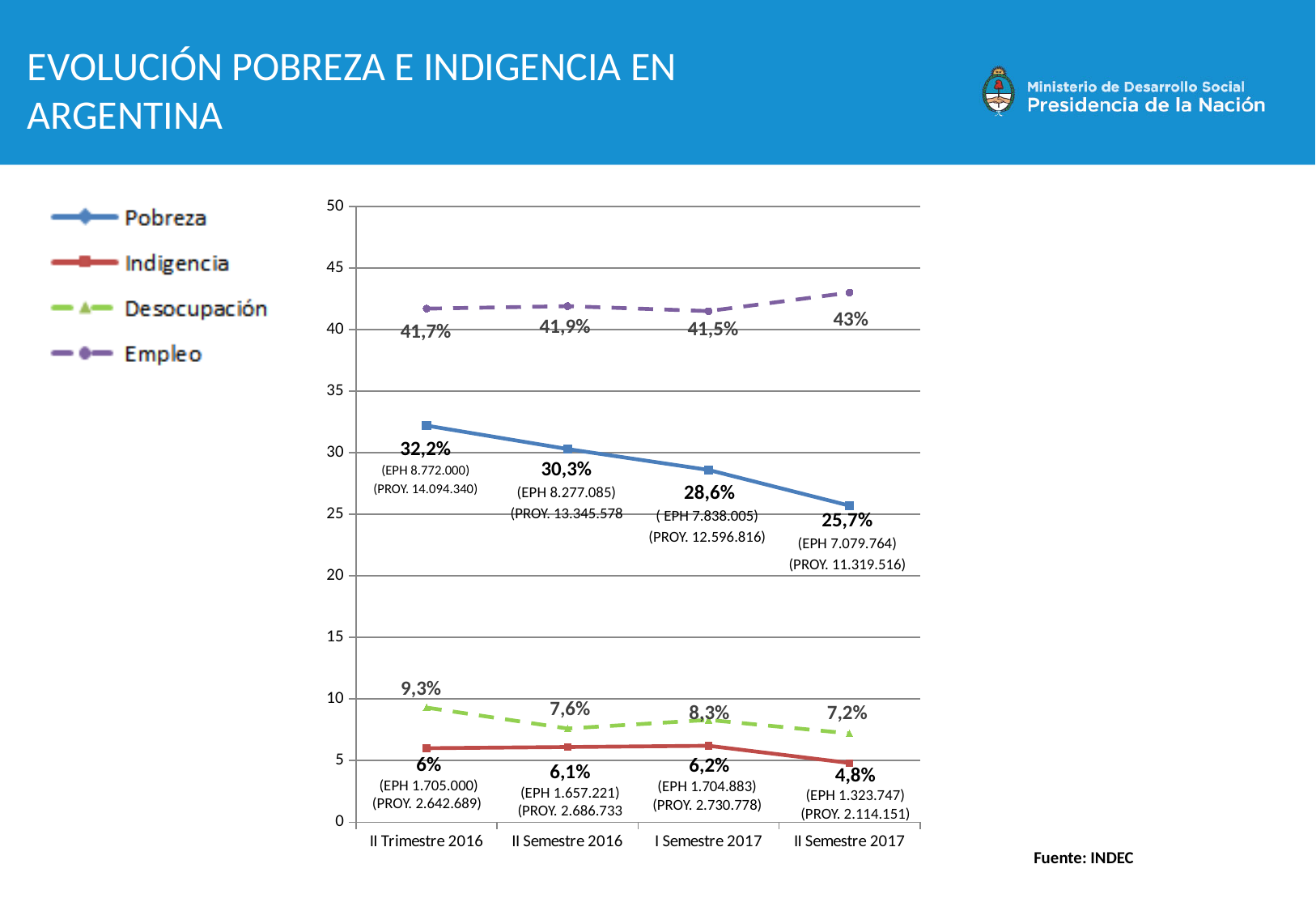
What is the Desocupación value for II Trimestre 2016? 9,3% Does the Pobreza series rise or fall from II Trimestre 2016 to II Semestre 2017? Fall What is the difference between the Pobreza values for II Trimestre 2016 and II Semestre 2017? 6,5% What kind of chart is shown on the slide? Line chart In which period is Pobreza highest? II Trimestre 2016 How many series does the legend list? 4 In which period is Indigencia lowest? II Semestre 2017 What is the Indigencia value for II Semestre 2016? 6,1% How many periods are shown on the x axis? 4 What is the Empleo value for I Semestre 2017? 41,5% Which is larger, Desocupación in II Semestre 2016 or in I Semestre 2017? I Semestre 2017 What is the Pobreza value for II Semestre 2017? 25,7%